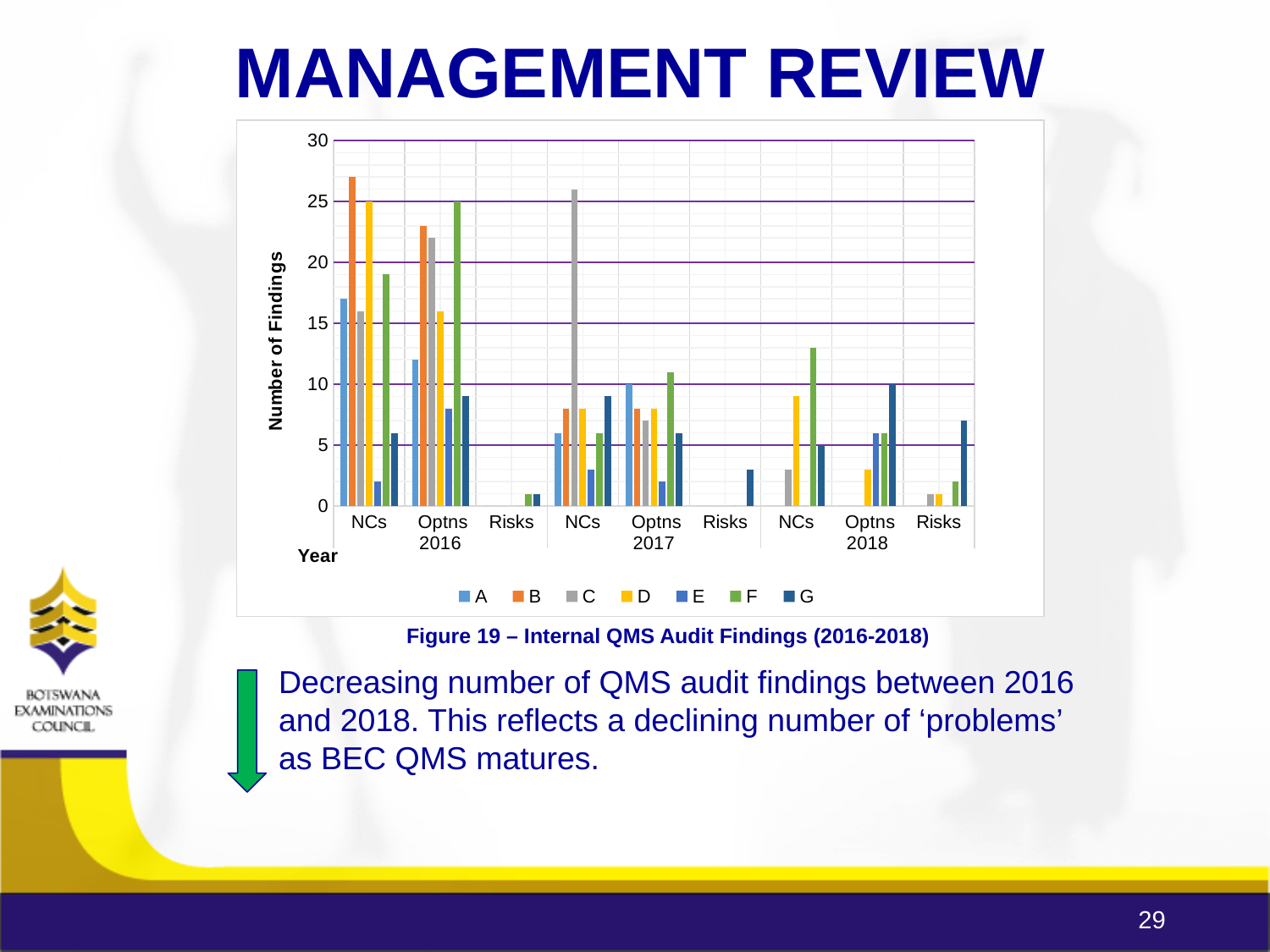
Which series has the highest value in the NCs 2017 group? C What is the caption given for the chart? Figure 19 – Internal QMS Audit Findings (2016-2018) Is the value for series B in NCs 2016 greater or less than 25? greater How many series does the legend of the chart list? 7 What is the label of the vertical axis of the chart? Number of Findings How many category groups are shown along the x axis of the chart? 9 Which series has the highest value in the NCs 2018 group? F Which is larger: series F in Optns 2016 or series F in NCs 2016? series F in Optns 2016 Is the value for series C in NCs 2017 greater or less than 25? greater Is the value for series G in Risks 2017 greater or less than 5? less What kind of chart is shown in Figure 19? bar chart